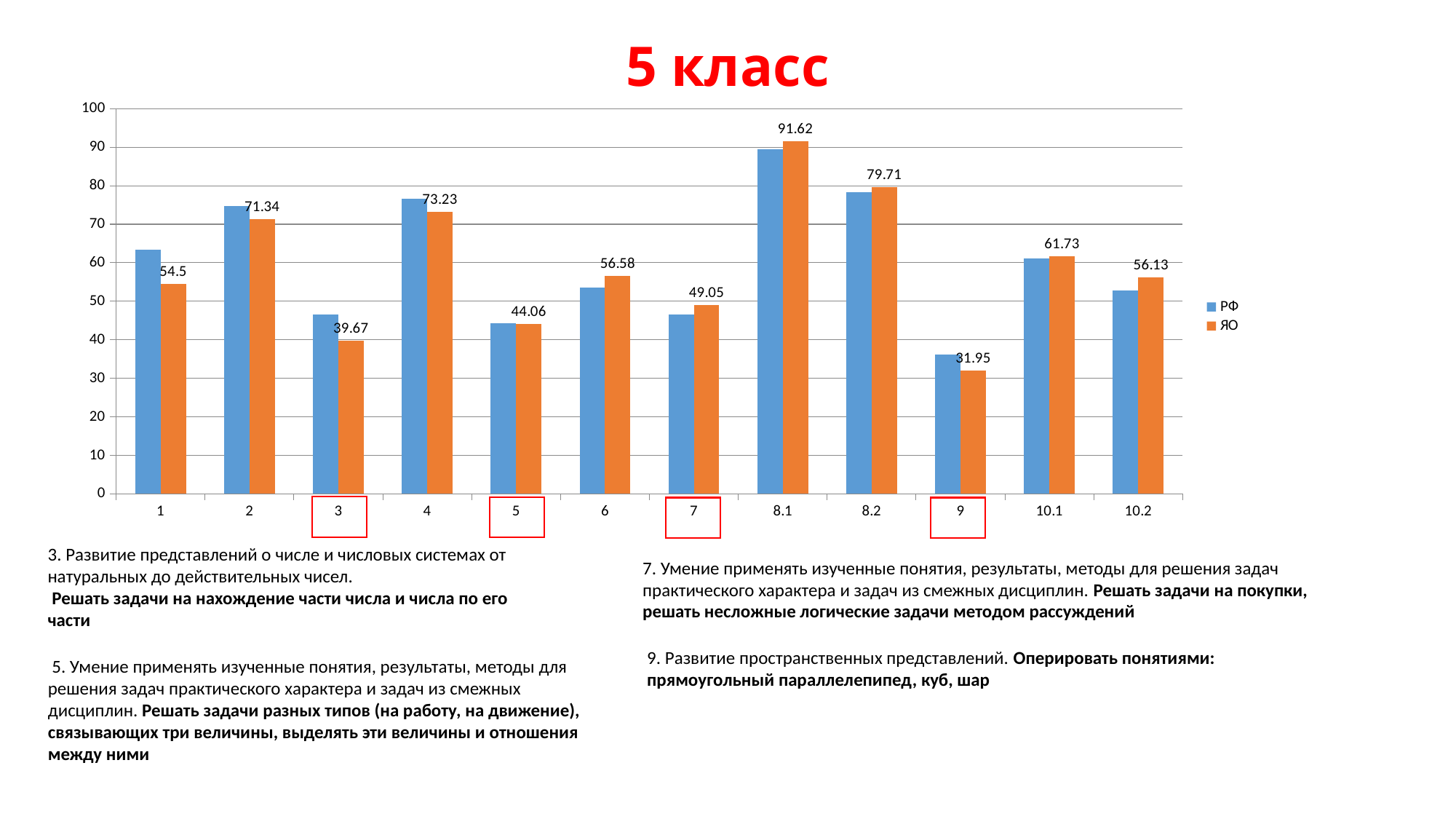
How many series does the legend list? 2 Is the РФ value for category 1 greater or less than 60? greater Which category has the lowest ЯО value? 9 What is the value of the ЯО series for category 8.1? 91.62 For category 1, which series has the larger value, РФ or ЯО? РФ Which category has the highest ЯО value? 8.1 What is the difference between the ЯО values for categories 8.1 and 8.2? 11.91 What is the value of the ЯО series for category 3? 39.67 Which category has the larger ЯО value, 2 or 4? 4 Is the РФ value for category 9 greater or less than 40? less What type of chart is shown on the slide? bar chart How many categories are shown on the x axis? 12